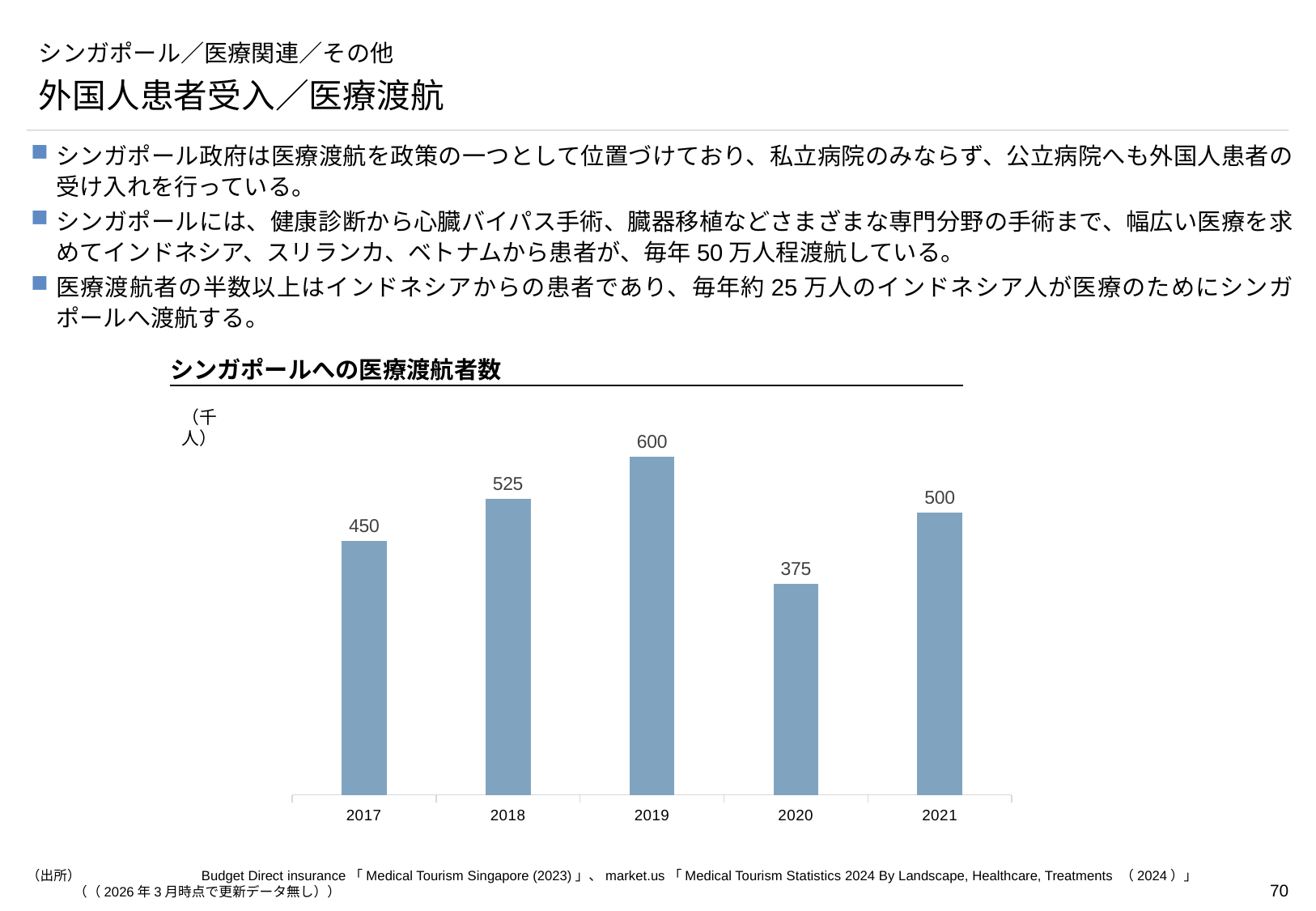
Does the value rise or fall from 2017 to 2019? Rise What is the value for 2017? 450 What is the difference between the values for 2019 and 2020? 225 Which year has the highest value? 2019 Which is larger, the value for 2018 or the value for 2021? 2018 What kind of chart is this? Bar chart What is the value for 2021? 500 What is the value for 2019? 600 Which year has the lowest value? 2020 How many years are shown on the x axis? 5 What is the value for 2020? 375 What is the title of the chart? シンガポールへの医療渡航者数